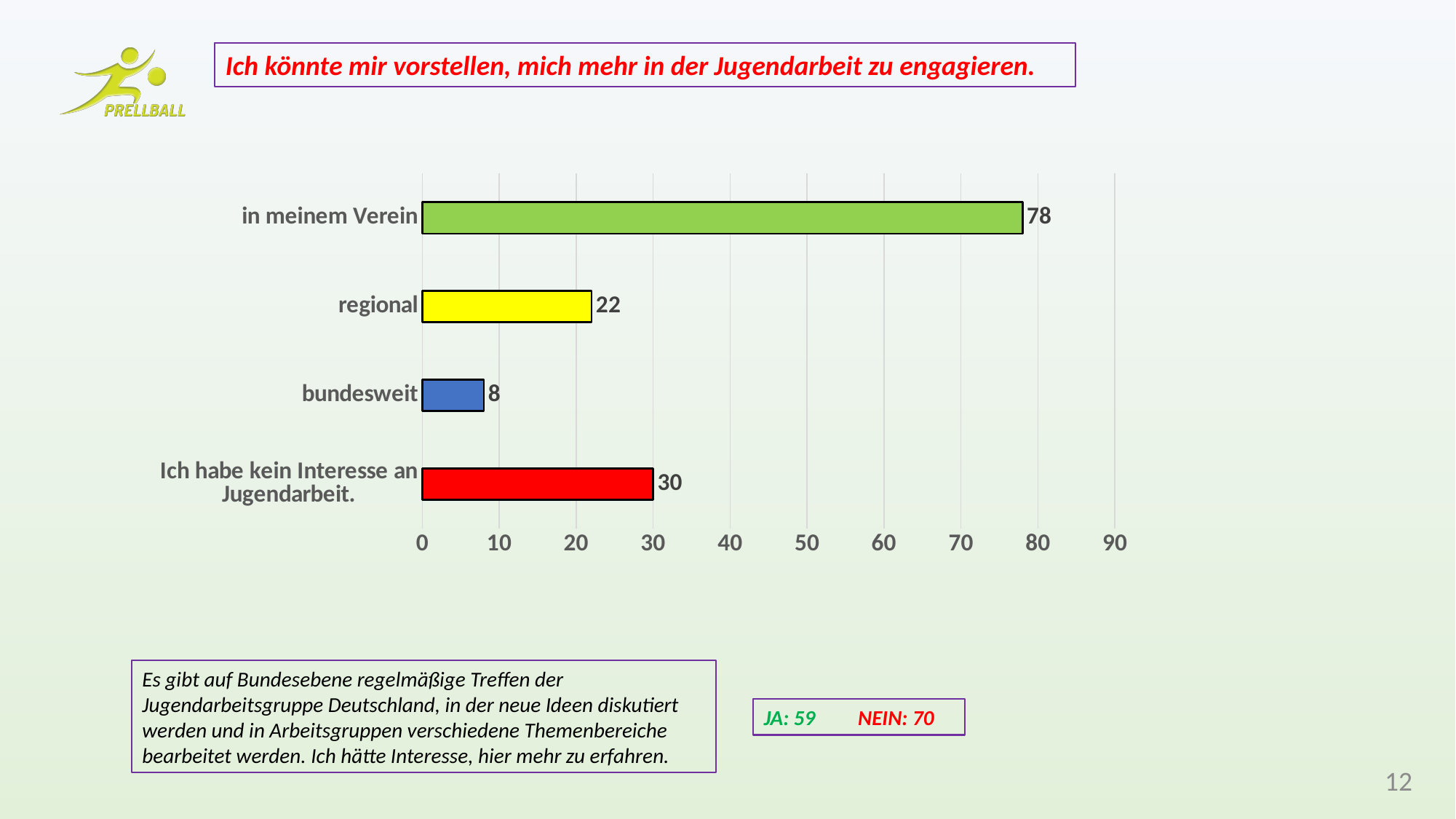
What colour is the bar for "bundesweit"? blue Which category has the highest value? in meinem Verein What kind of chart is shown on the slide? bar chart Which category has the lowest value? bundesweit What is the value for "in meinem Verein"? 78 How many categories are shown in the chart? 4 What is the difference between the values for "Ich habe kein Interesse an Jugendarbeit." and "bundesweit"? 22 What is the value for "Ich habe kein Interesse an Jugendarbeit."? 30 What is the difference between the values for "in meinem Verein" and "regional"? 56 What is the value for "regional"? 22 Which is larger, the value for "regional" or the value for "Ich habe kein Interesse an Jugendarbeit."? Ich habe kein Interesse an Jugendarbeit. What is the value for "bundesweit"? 8